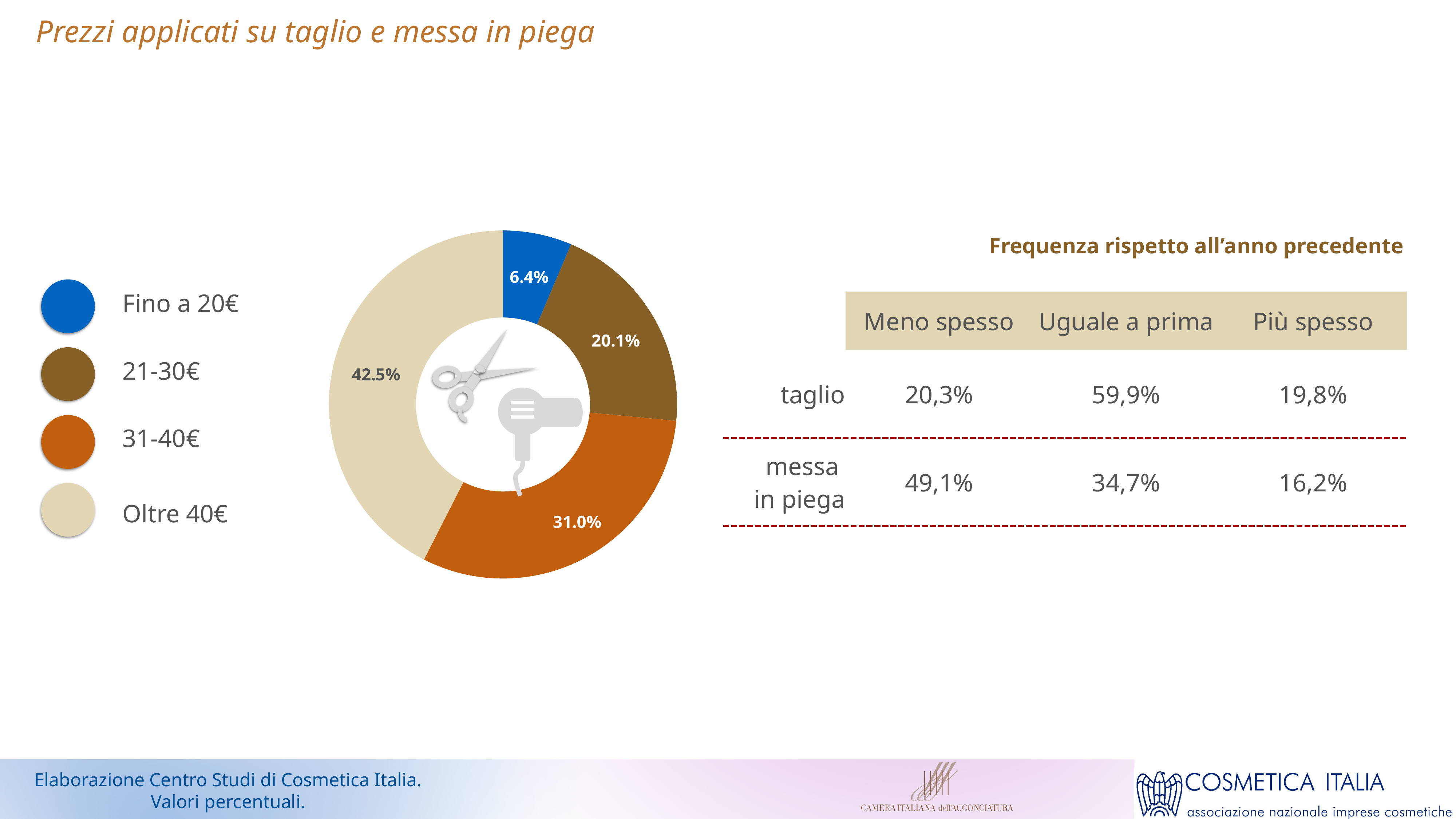
Which slice is larger, "21-30€" or "31-40€"? 31-40€ What value is shown for the "Fino a 20€" slice? 6.4% What kind of chart is shown on the left of the slide? Donut (pie) chart What share of the donut chart is labelled "Oltre 40€"? 42.5% What value is shown for the "31-40€" slice? 31.0% Which price band has the smallest slice in the donut chart? Fino a 20€ How many price bands are shown in the donut chart? 4 What is the title of the slide containing the donut chart? Prezzi applicati su taglio e messa in piega What colour represents the "Fino a 20€" category in the legend? Blue What is the difference between the "Oltre 40€" slice and the "31-40€" slice? 11.5% Which price band has the largest slice in the donut chart? Oltre 40€ What value is shown for the "21-30€" slice? 20.1%